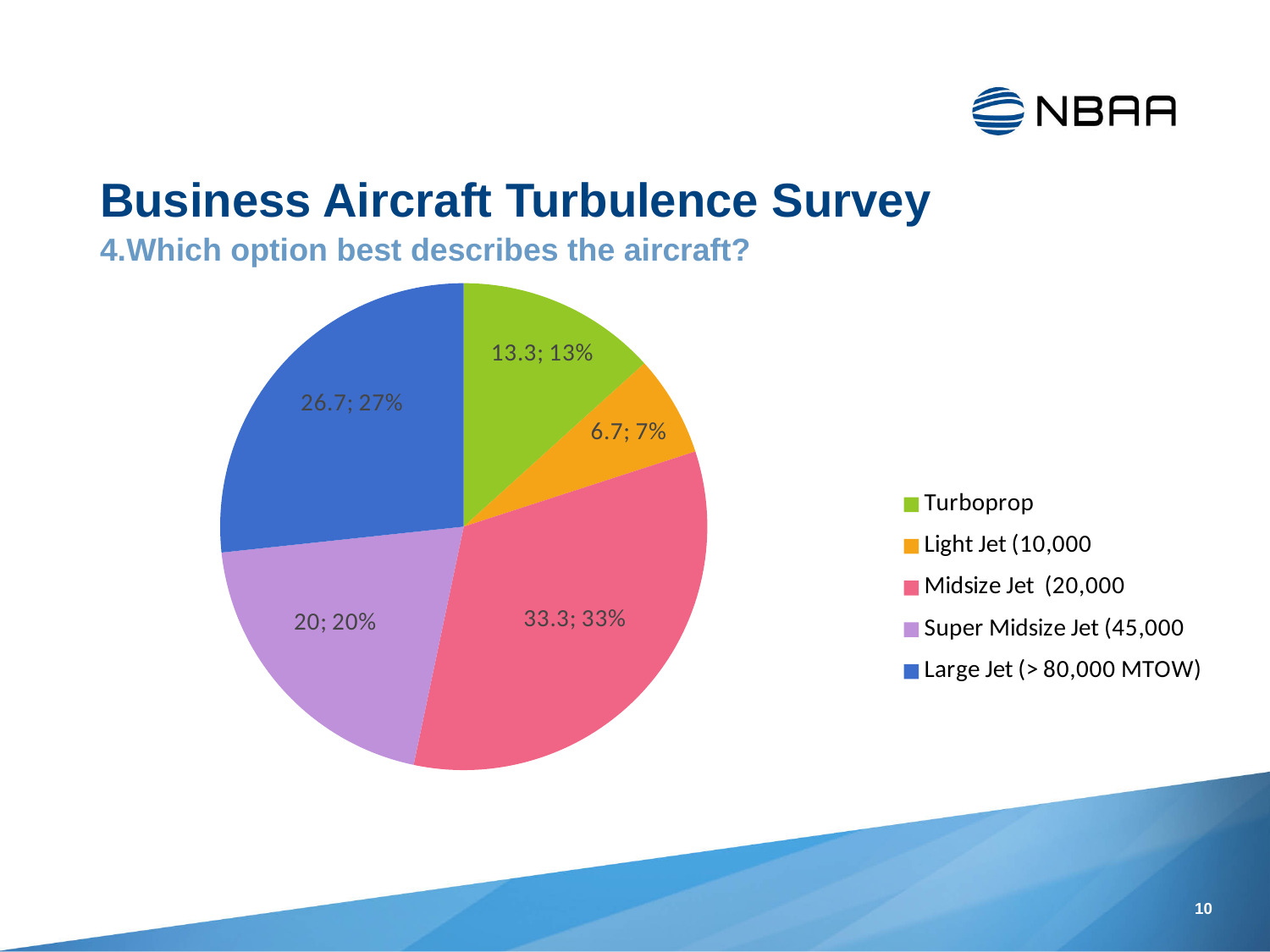
What percentage share of the pie does the Turboprop slice represent? 13% What percentage share of the pie does the Super Midsize Jet slice represent? 20% Which slice is larger, Large Jet or Turboprop? Large Jet Which aircraft category has the largest slice of the pie? Midsize Jet What value is labelled on the Large Jet slice? 26.7 What kind of chart is shown on the slide? Pie chart What percentage share of the pie does the Midsize Jet slice represent? 33% Which aircraft category has the smallest slice of the pie? Light Jet What value is labelled on the Light Jet slice? 6.7 What colour is the Midsize Jet slice? Pink How many slices does the pie chart have? 5 What is the difference between the Midsize Jet value (33.3) and the Super Midsize Jet value (20)? 13.3